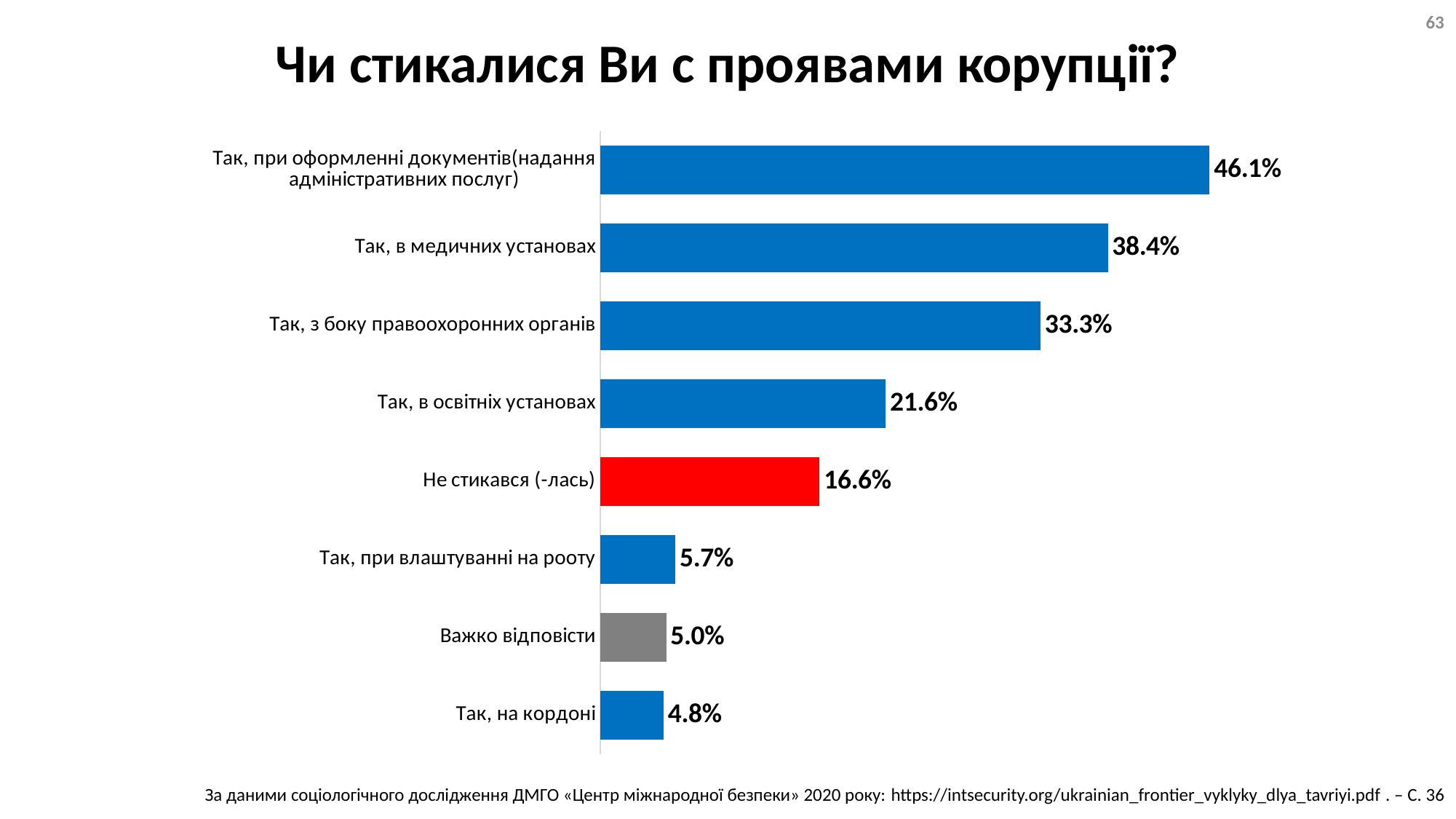
What value is shown for "Так, в освітніх установах"? 21.6% Which category has the lowest value? Так, на кордоні What value is shown for "Так, на кордоні"? 4.8% Which category's bar is coloured red? Не стикався (-лась) Which is larger: the value for "Так, при влаштуванні на рооту" or the value for "Важко відповісти"? Так, при влаштуванні на рооту Which category has the highest value? Так, при оформленні документів(надання адміністративних послуг) What value is shown for "Так, в медичних установах"? 38.4% What value is shown for "Не стикався (-лась)"? 16.6% How many categories are shown in the chart? 8 What kind of chart is shown on the slide? Bar chart What is the difference between the values for "Так, при оформленні документів(надання адміністративних послуг)" and "Не стикався (-лась)"? 29.5% What is the difference between the values for "Так, в медичних установах" and "Так, з боку правоохоронних органів"? 5.1%